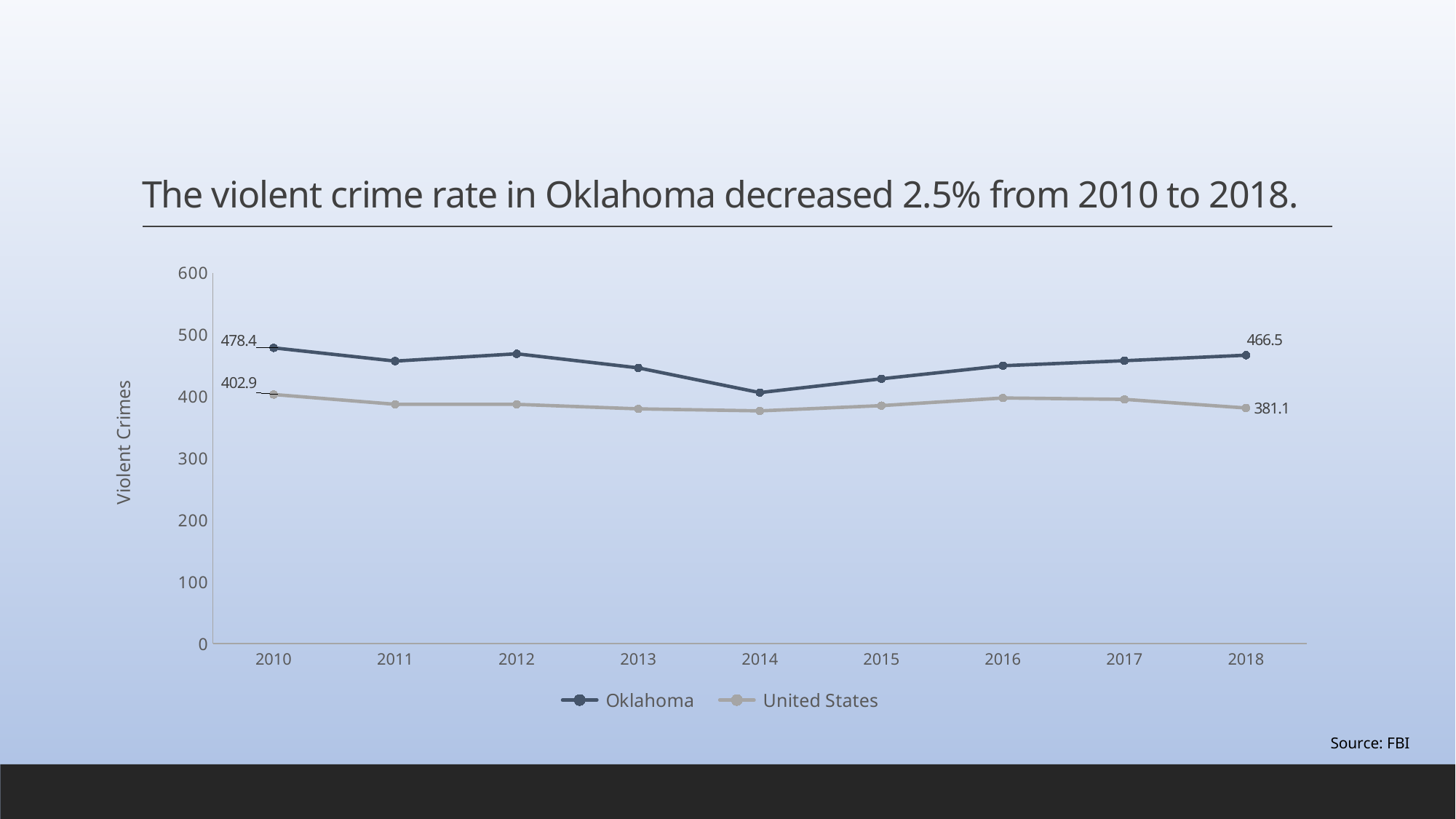
What was the violent crime rate in Oklahoma in 2018? 466.5 How many series does the legend list? 2 Is the United States value for 2016 greater or less than 300? greater What was the violent crime rate in the United States in 2010? 402.9 What is the difference between the Oklahoma and United States violent crime rates in 2018? 85.4 What was the violent crime rate in the United States in 2018? 381.1 By how much did the Oklahoma violent crime rate change from 2010 to 2018? 11.9 Is the Oklahoma value for 2014 greater or less than 500? less Which series had the higher violent crime rate in 2014, Oklahoma or United States? Oklahoma What was the violent crime rate in Oklahoma in 2010? 478.4 What kind of chart is shown on the slide? Line chart How many years are shown on the x axis? 9